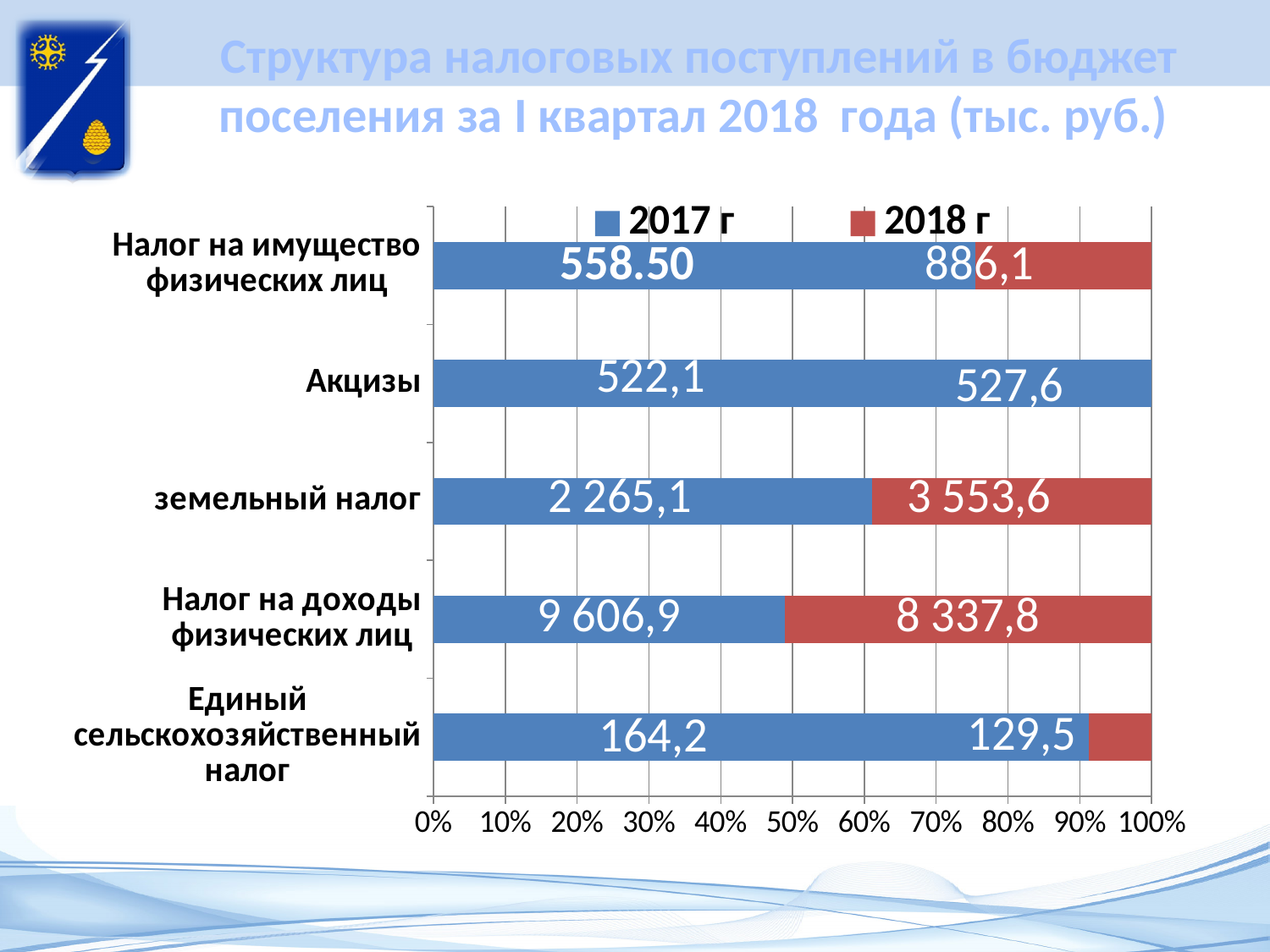
What is the 2018 г value for Налог на имущество физических лиц? 886,1 What is the difference between the 2018 г and 2017 г values for земельный налог? 1 288,5 What is the difference between the 2017 г and 2018 г values for Налог на доходы физических лиц? 1 269,1 Which category has the highest 2017 г value? Налог на доходы физических лиц How many categories are shown on the chart? 5 What kind of chart is shown on the slide? Stacked bar chart How many series does the legend list? 2 What is the 2017 г value for Единый сельскохозяйственный налог? 164,2 Which category has the lowest 2018 г value? Единый сельскохозяйственный налог What is the 2017 г value for земельный налог? 2 265,1 What is the 2018 г value for Налог на доходы физических лиц? 8 337,8 Which is larger for Акцизы: the 2017 г value or the 2018 г value? 2018 г